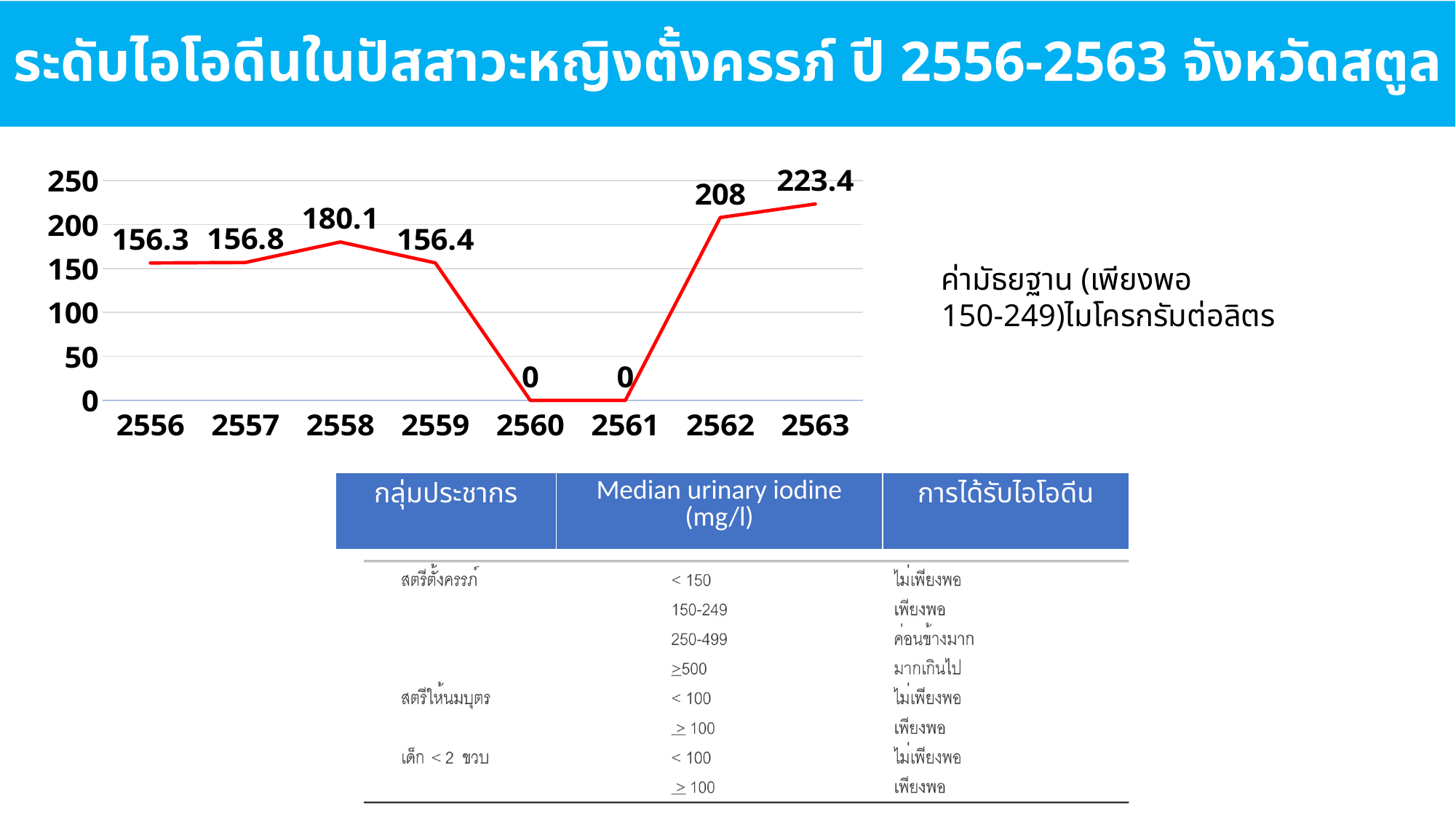
Which is larger, the value for 2557 or the value for 2559? 2557 Which years have a value of 0? 2560 and 2561 Do the values rise or fall from 2561 to 2563? rise Is the value for 2562 greater or less than 200? greater How many years are plotted on the x axis? 8 What colour is the plotted line? red What is the value for 2556? 156.3 What is the value for 2558? 180.1 What is the value for 2563? 223.4 What is the difference between the values for 2563 and 2562? 15.4 What kind of chart is shown? line chart Which year has the highest value? 2563